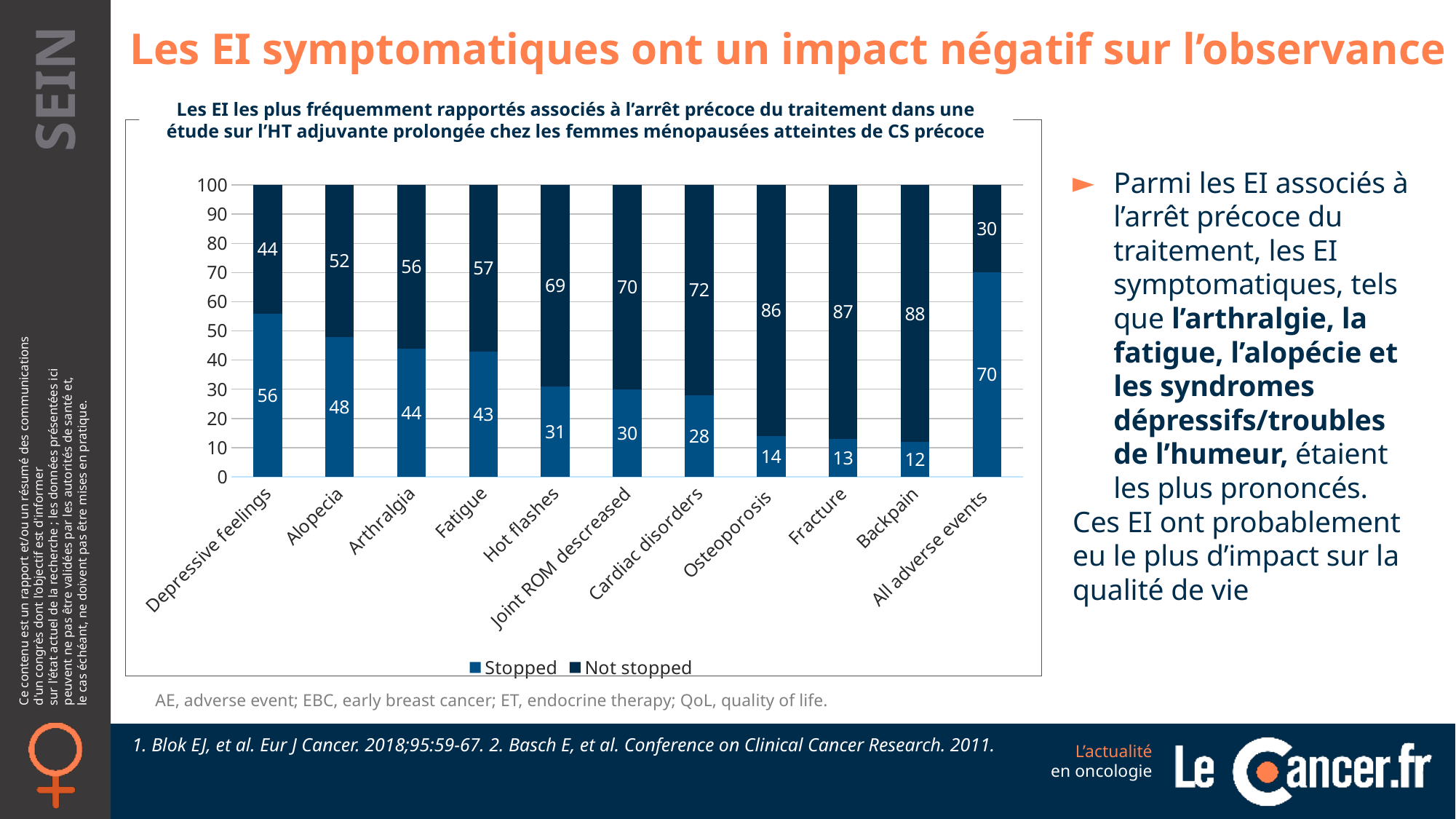
Which is larger, the 'Stopped' value for Hot flashes or for Cardiac disorders? Hot flashes What is the 'Not stopped' value for Osteoporosis? 86 What is the total of the stacked bar for Arthralgia? 100 What is the difference between the 'Stopped' values for Alopecia and Fatigue? 5 What is the 'Stopped' value for Depressive feelings? 56 What are the two legend entries? Stopped, Not stopped What kind of chart is shown? Stacked bar chart Which category has the highest 'Not stopped' value? Backpain What is the 'Stopped' value for All adverse events? 70 How many series does the legend list? 2 Which category has the lowest 'Stopped' value? Backpain How many categories are shown on the x axis? 11